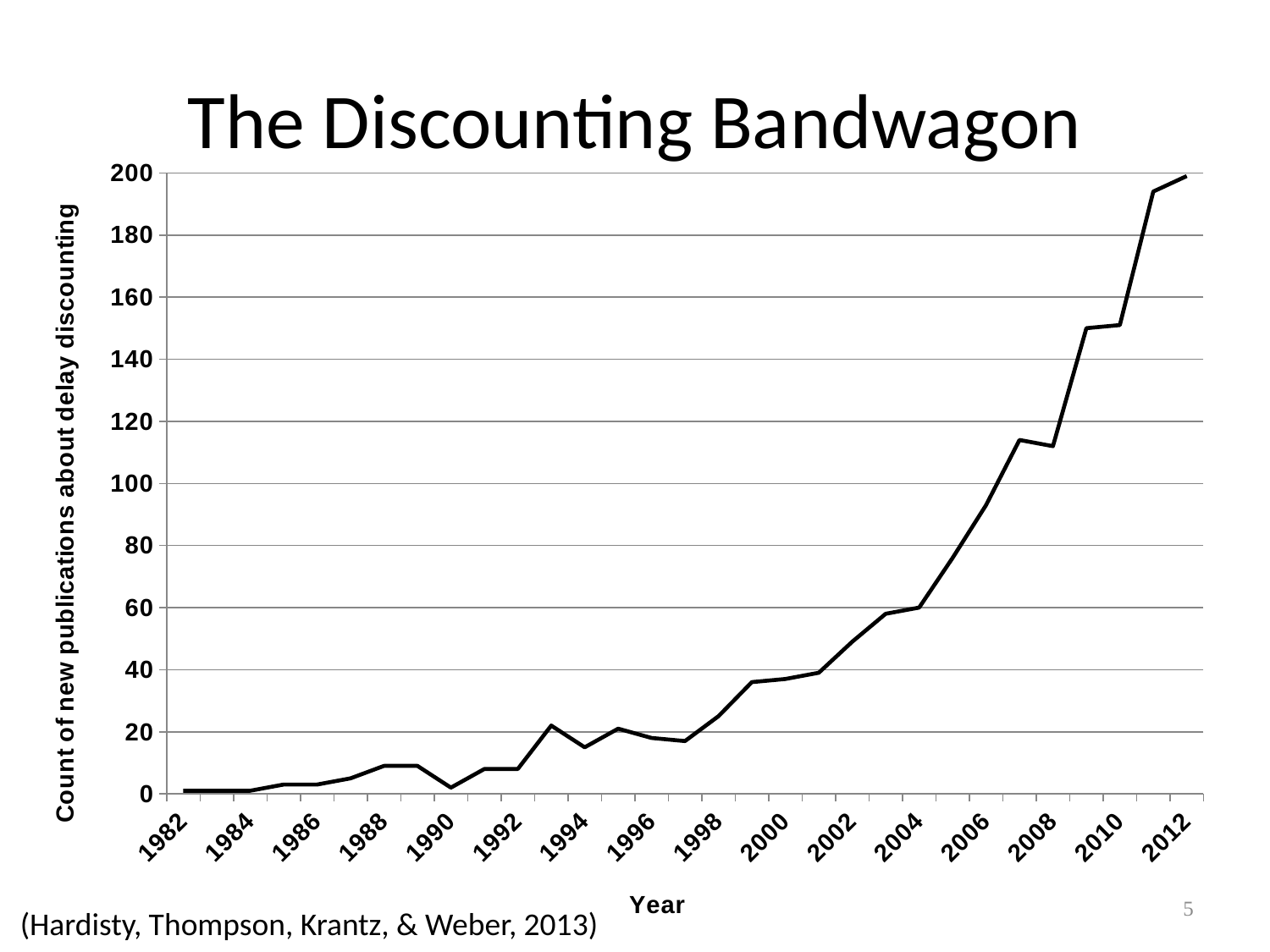
Which year has the highest count of new publications? 2012 Is the value for 2012 greater or less than 180? greater Is the value for 2010 greater or less than 140? greater Is the value for 2008 greater or less than 100? greater Overall, do the values rise or fall from 1982 to 2012? rise How many year labels are shown on the x axis? 16 What is the title of the chart? The Discounting Bandwagon What is the label of the vertical axis? Count of new publications about delay discounting Which year has the larger value, 2004 or 2008? 2008 What kind of chart is shown on the slide? line chart